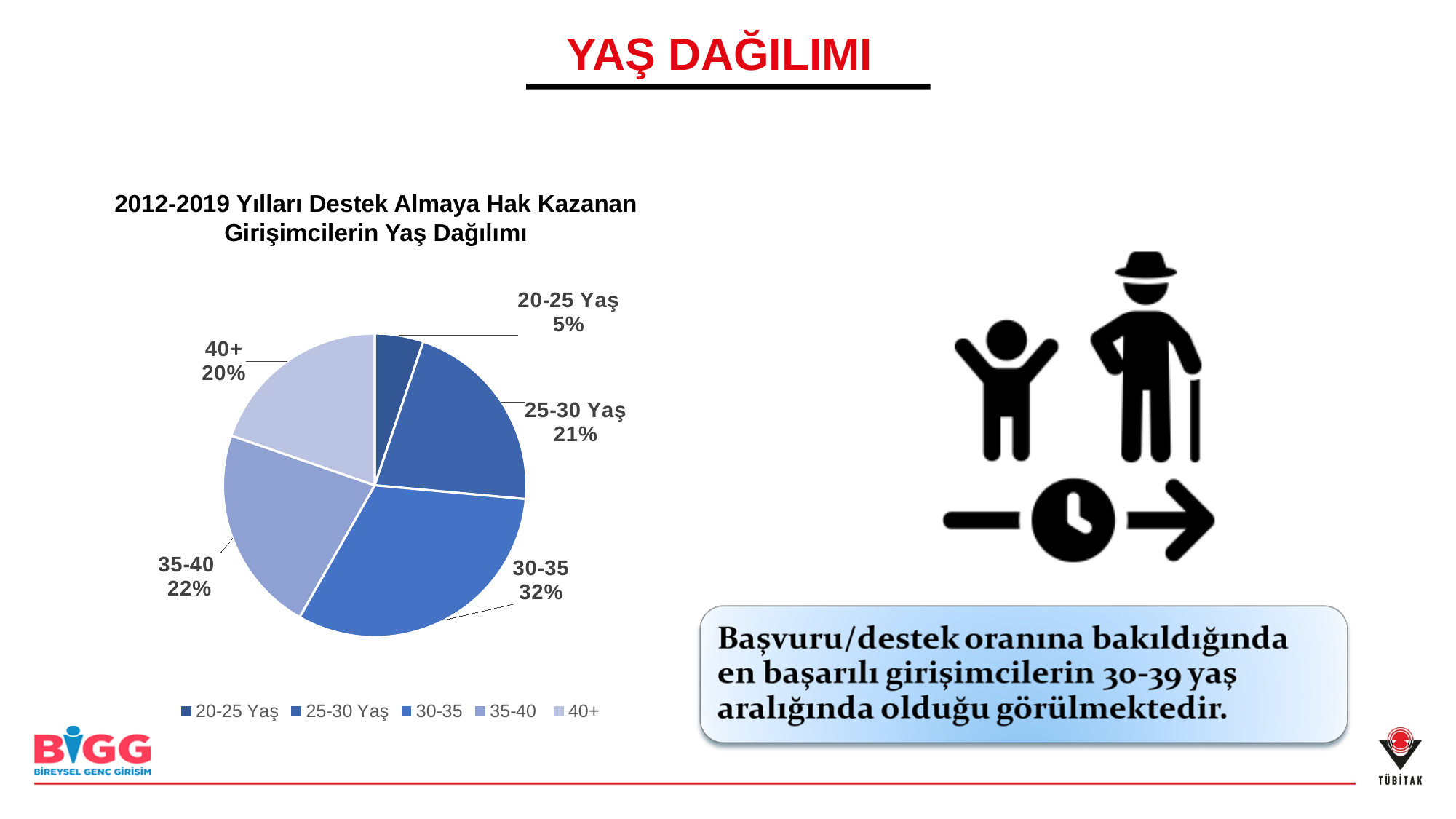
What type of chart is shown on the slide? Pie chart What is the difference between the shares of the 30-35 and 25-30 Yaş groups? 11% Which age group has the smallest share of the pie? 20-25 Yaş How many entries does the legend list? 5 What share of the pie does the 30-35 age group have? 32% Which is larger, the share for 35-40 or the share for 40+? 35-40 Which age group has the largest share of the pie? 30-35 How many age groups are shown in the pie chart? 5 What is the value shown for the 40+ slice? 20% What is the value shown for the 20-25 Yaş slice? 5% What is the title of the chart? 2012-2019 Yılları Destek Almaya Hak Kazanan Girişimcilerin Yaş Dağılımı What is the value shown for the 35-40 slice? 22%